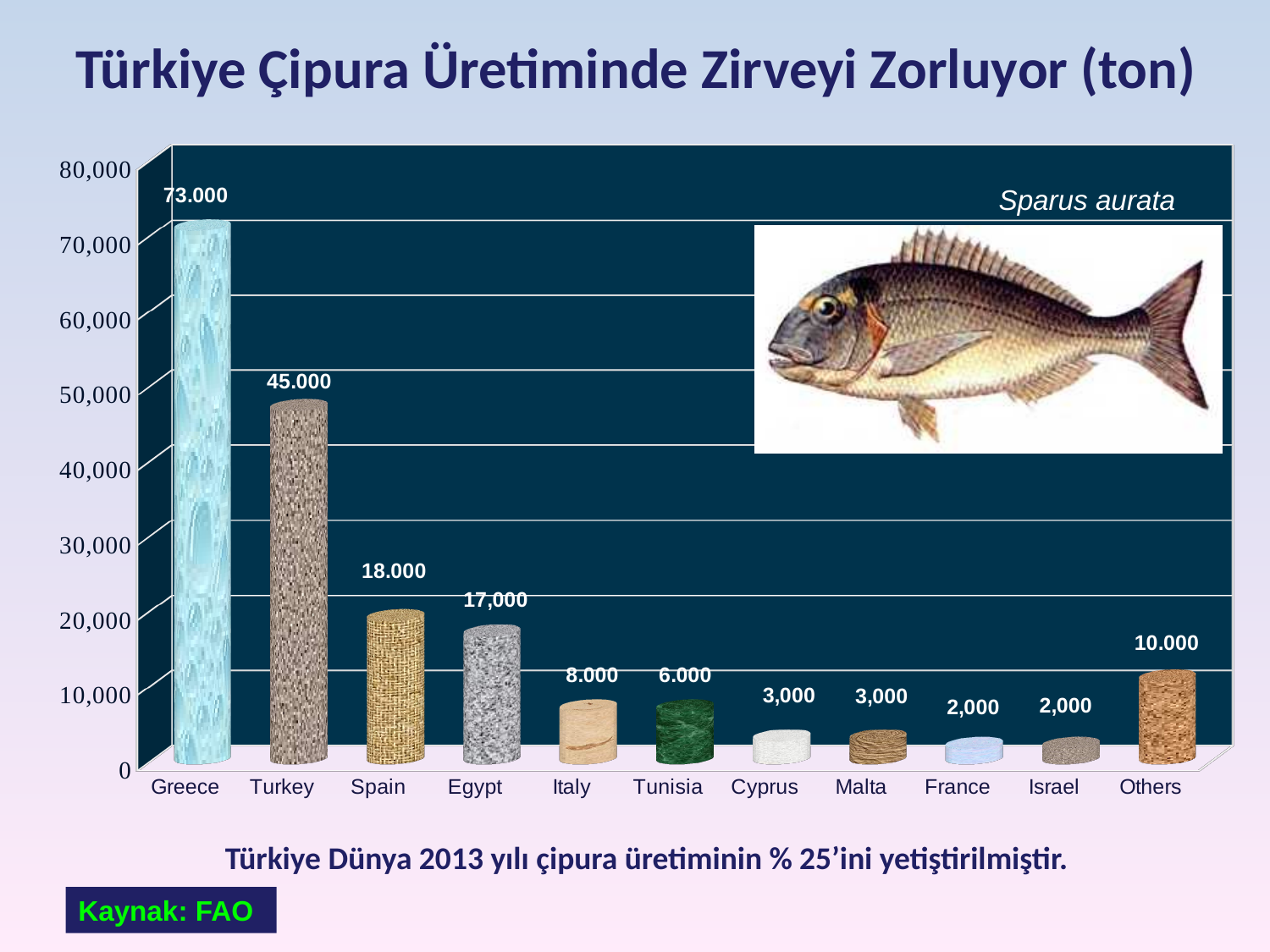
Is the value for Turkey greater or less than 40,000? greater Which country has the highest value in the chart? Greece What is the difference between the values for Cyprus and France? 1,000 What kind of chart is shown on the slide? bar chart What is the difference between the values for Greece and Turkey? 28.000 How many categories are shown on the x axis? 11 What is the title of the slide? Türkiye Çipura Üretiminde Zirveyi Zorluyor (ton) What is the value shown for Greece? 73.000 What is the value shown for Turkey? 45.000 What is the value shown for Others? 10.000 Which has a larger value, Spain or Italy? Spain What is the value shown for Egypt? 17,000